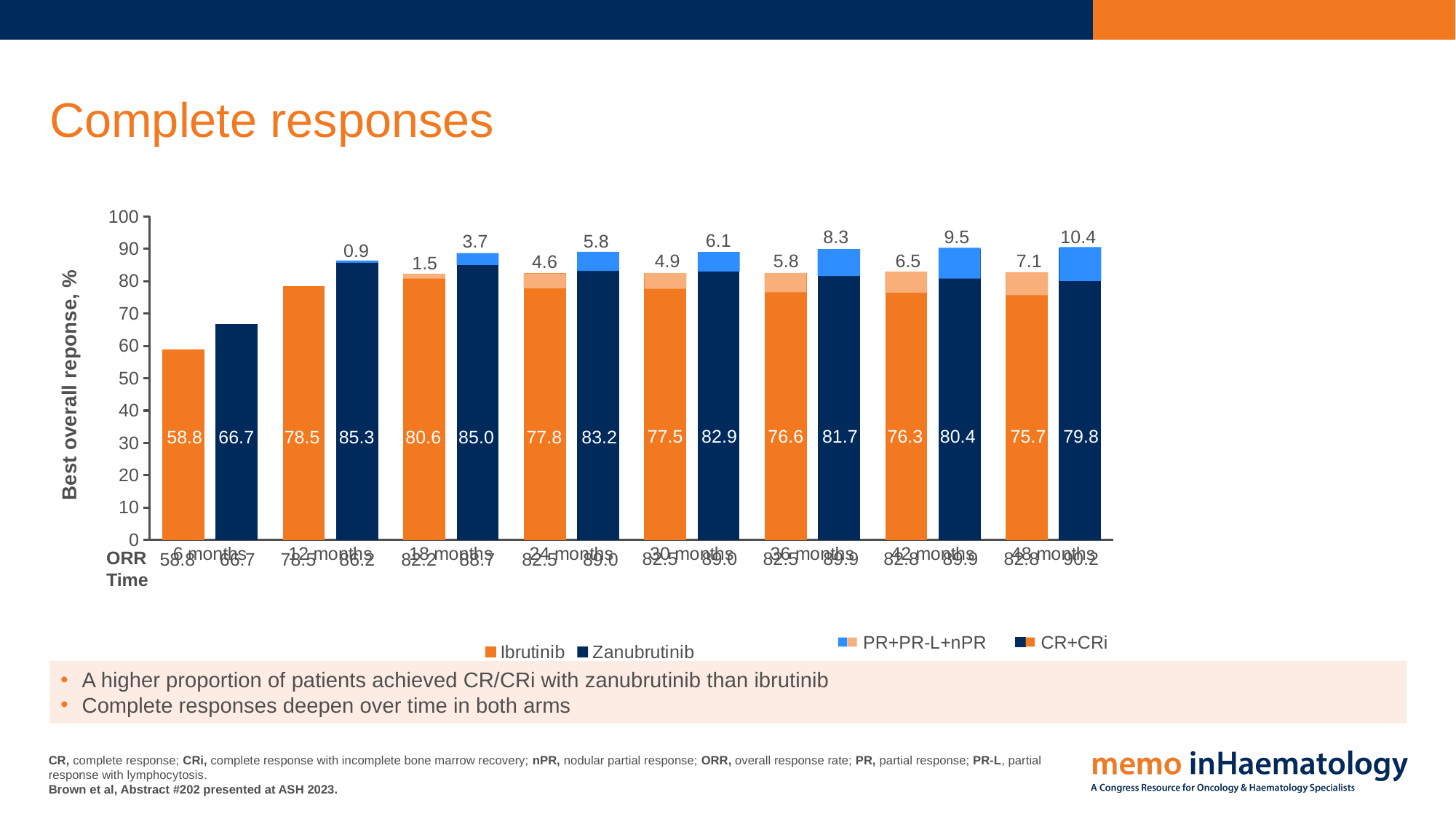
At 24 months, which arm has the higher CR+CRi value, ibrutinib or zanubrutinib? Zanubrutinib At 12 months, how much higher is the zanubrutinib CR+CRi value than the ibrutinib CR+CRi value? 6.8 At which time point is the zanubrutinib CR+CRi value highest? 12 months What is the total height (ORR) of the zanubrutinib stacked bar at 48 months? 90.2 At which time point is the ibrutinib CR+CRi value lowest? 6 months How many time points are shown on the x axis? 8 What is the PR+PR-L+nPR value for ibrutinib at 36 months? 5.8 What kind of chart is shown on the slide? Stacked bar chart What is the PR+PR-L+nPR value for zanubrutinib at 48 months? 10.4 What is the CR+CRi value for zanubrutinib at 48 months? 79.8 Does the ibrutinib CR+CRi value rise or fall from 18 months to 48 months? Fall What is the CR+CRi value for ibrutinib at 6 months? 58.8